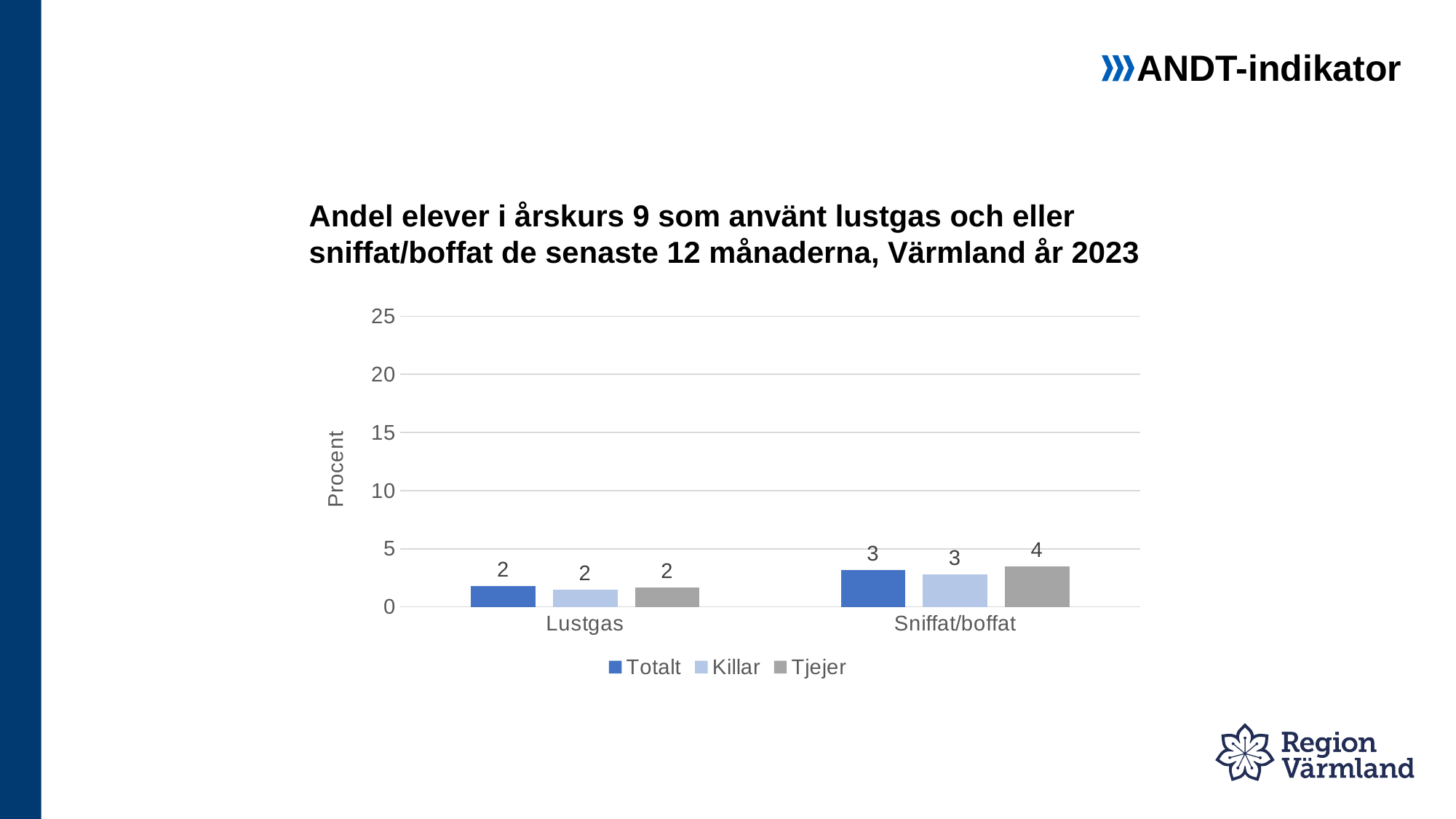
What is the difference between the Tjejer value for Sniffat/boffat and the Tjejer value for Lustgas? 2 What kind of chart is shown on the slide? bar chart What is the value for Totalt in the Lustgas category? 2 What is the label on the y axis? Procent What is the value for Tjejer in the Sniffat/boffat category? 4 Is the value for Tjejer in the Sniffat/boffat category greater or less than 5? less How many series does the legend list? 3 What is the value for Killar in the Sniffat/boffat category? 3 Which series has the highest value in the Sniffat/boffat category? Tjejer How many categories are shown on the x axis? 2 Which is larger for Totalt: the value for Lustgas or the value for Sniffat/boffat? Sniffat/boffat What is the difference between the Tjejer value and the Totalt value in the Sniffat/boffat category? 1